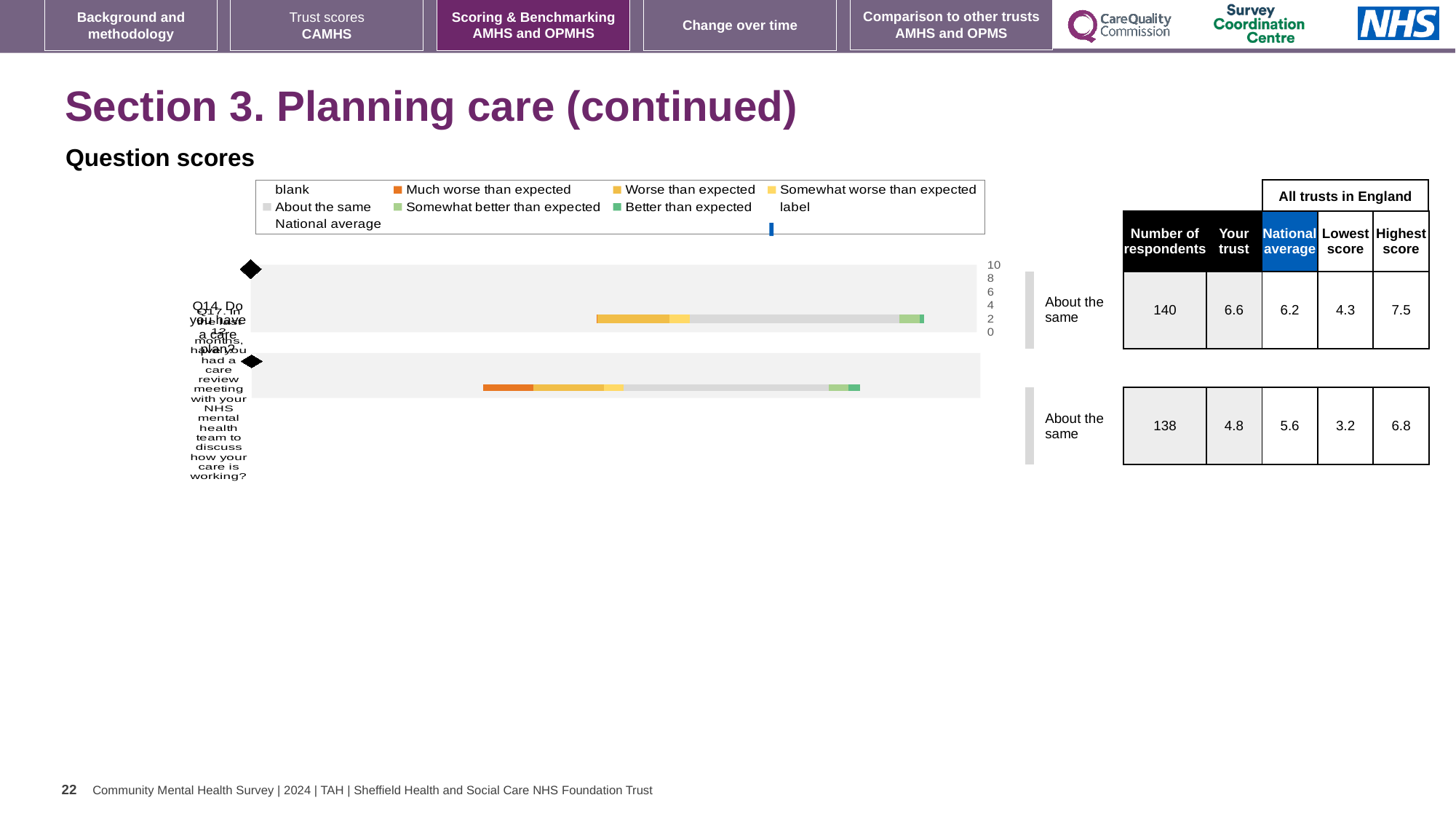
What is the difference between the highest score and the lowest score for Q17? 3.6 In the table beside the chart, what is the national average for Q14? 6.2 What is the difference between the highest score and the lowest score for Q14? 3.2 How many questions (bars) are plotted in the chart? 2 For Q17, which is larger: the 'Your trust' score or the national average? National average What colour does the legend use for 'Much worse than expected'? orange What colour does the legend use for 'Better than expected'? green What kind of chart is shown under 'Question scores'? bar chart In the table beside the chart, what is the 'Your trust' score for Q17? 4.8 In the table beside the chart, how many respondents are listed for Q14? 140 For Q14, which is larger: the 'Your trust' score or the national average? Your trust Which question has the higher 'Your trust' score, Q14 or Q17? Q14